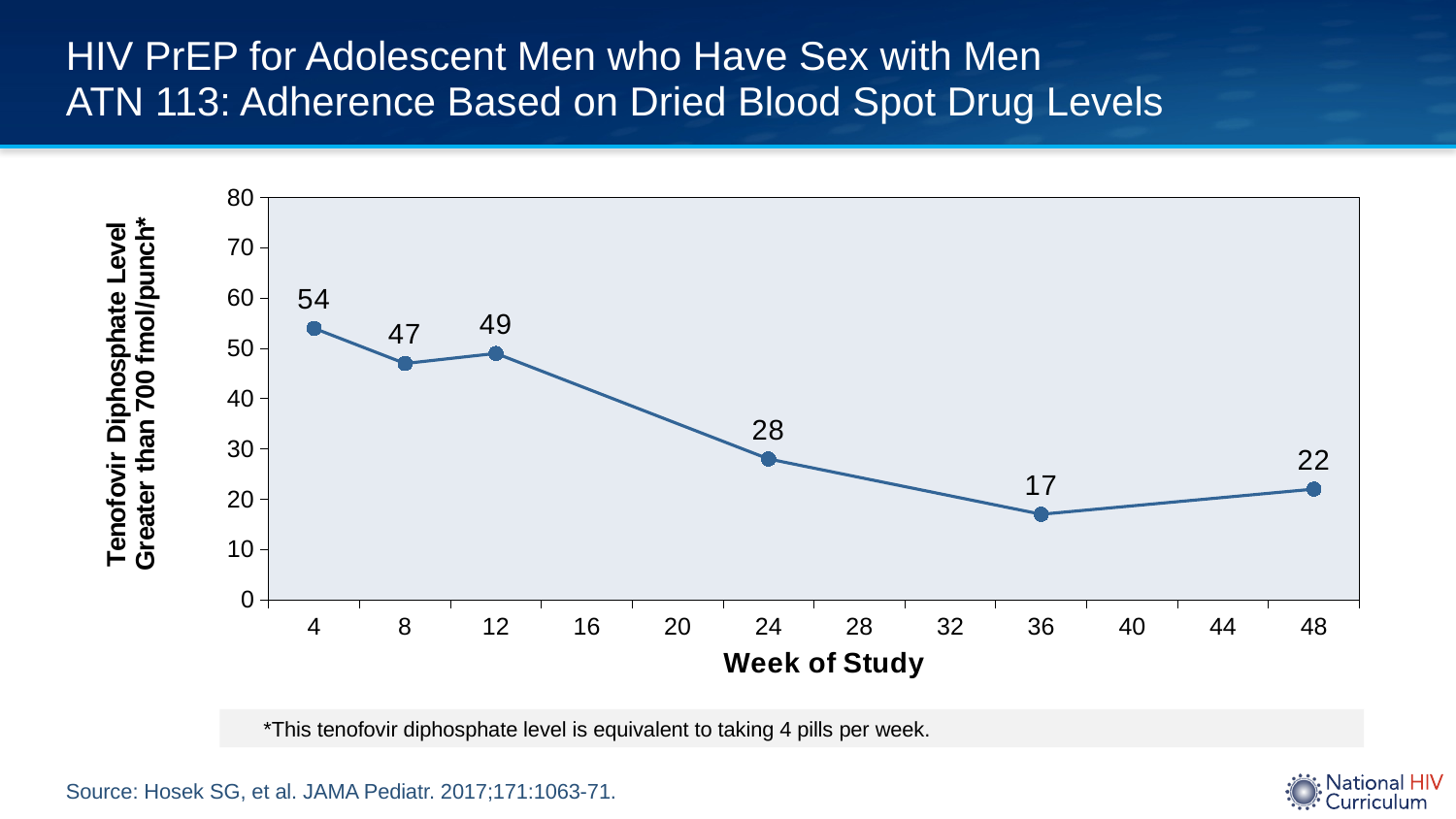
How many data points are plotted on the chart? 6 What is the difference between the values at week 4 and week 36? 37 At which week of study is the value lowest? 36 Which is larger, the value at week 8 or the value at week 12? week 12 Is the value at week 24 greater or less than 30? less What is the label of the x axis? Week of Study What kind of chart is shown on the slide? line chart At which week of study is the value highest? 4 What is the value at week 36? 17 What is the value at week 48? 22 What is the value at week 4? 54 What is the difference between the values at week 12 and week 24? 21